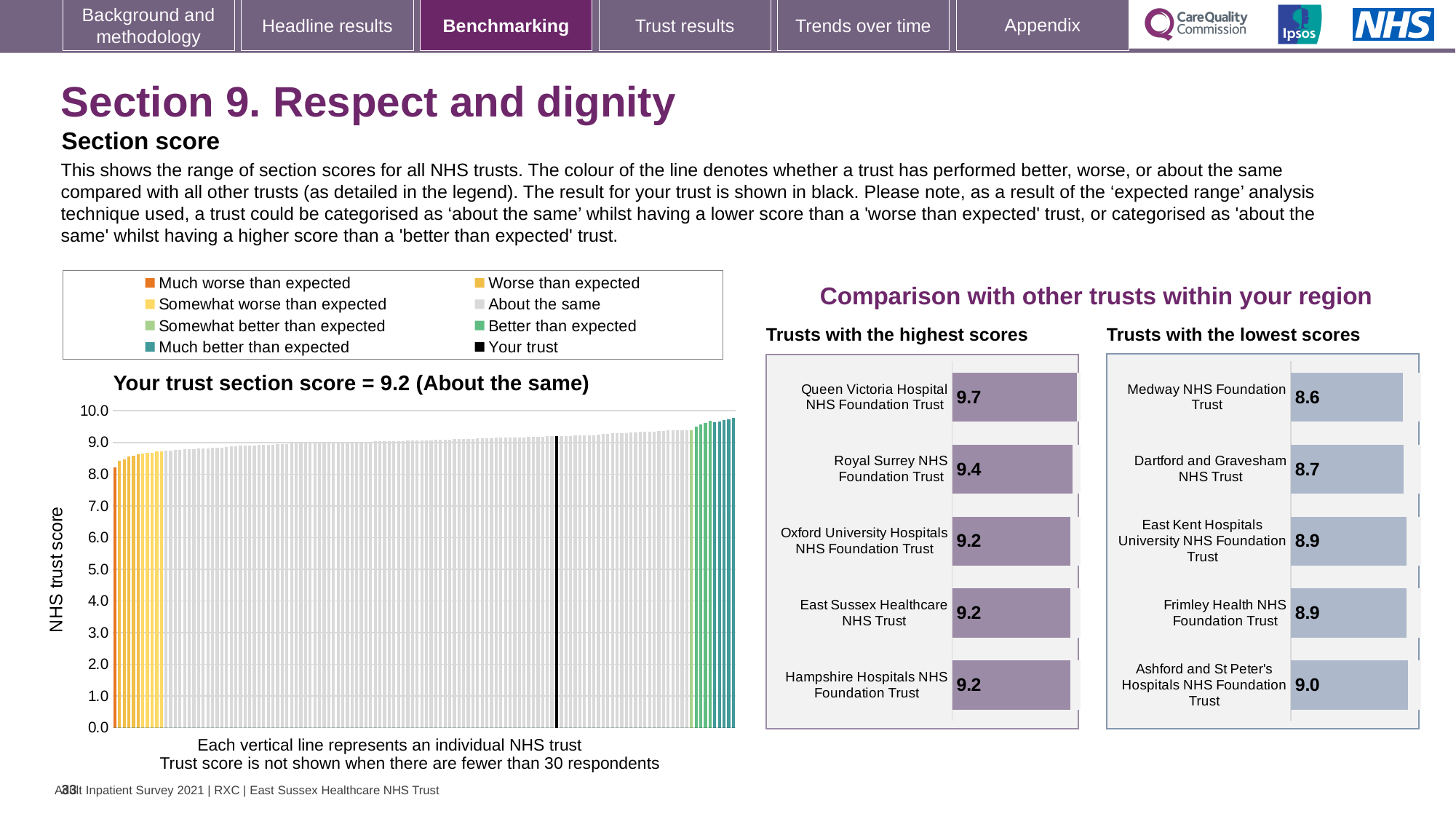
In the 'Your trust section score' chart, do the trust scores rise or fall from left to right? rise In the 'Trusts with the highest scores' chart, which trust has the highest score? Queen Victoria Hospital NHS Foundation Trust How many entries does the legend above the 'Your trust section score' chart list? 8 In the 'Trusts with the lowest scores' chart, which has the larger score: Dartford and Gravesham NHS Trust or Medway NHS Foundation Trust? Dartford and Gravesham NHS Trust In the 'Your trust section score' chart, what is the section score for your trust? 9.2 In the 'Trusts with the lowest scores' chart, which trust has the lowest score? Medway NHS Foundation Trust In the 'Trusts with the highest scores' chart, what is the score for Queen Victoria Hospital NHS Foundation Trust? 9.7 In the 'Your trust section score' chart, what is the label on the vertical axis? NHS trust score In the 'Your trust section score' chart, is the value for the highest-scoring trust greater or less than 10.0? less In the 'Trusts with the highest scores' chart, what is the difference between the scores of Queen Victoria Hospital NHS Foundation Trust and Royal Surrey NHS Foundation Trust? 0.3 In the 'Trusts with the lowest scores' chart, how many trusts are shown? 5 In the 'Your trust section score' chart, what kind of chart is used to show the trust scores? bar chart